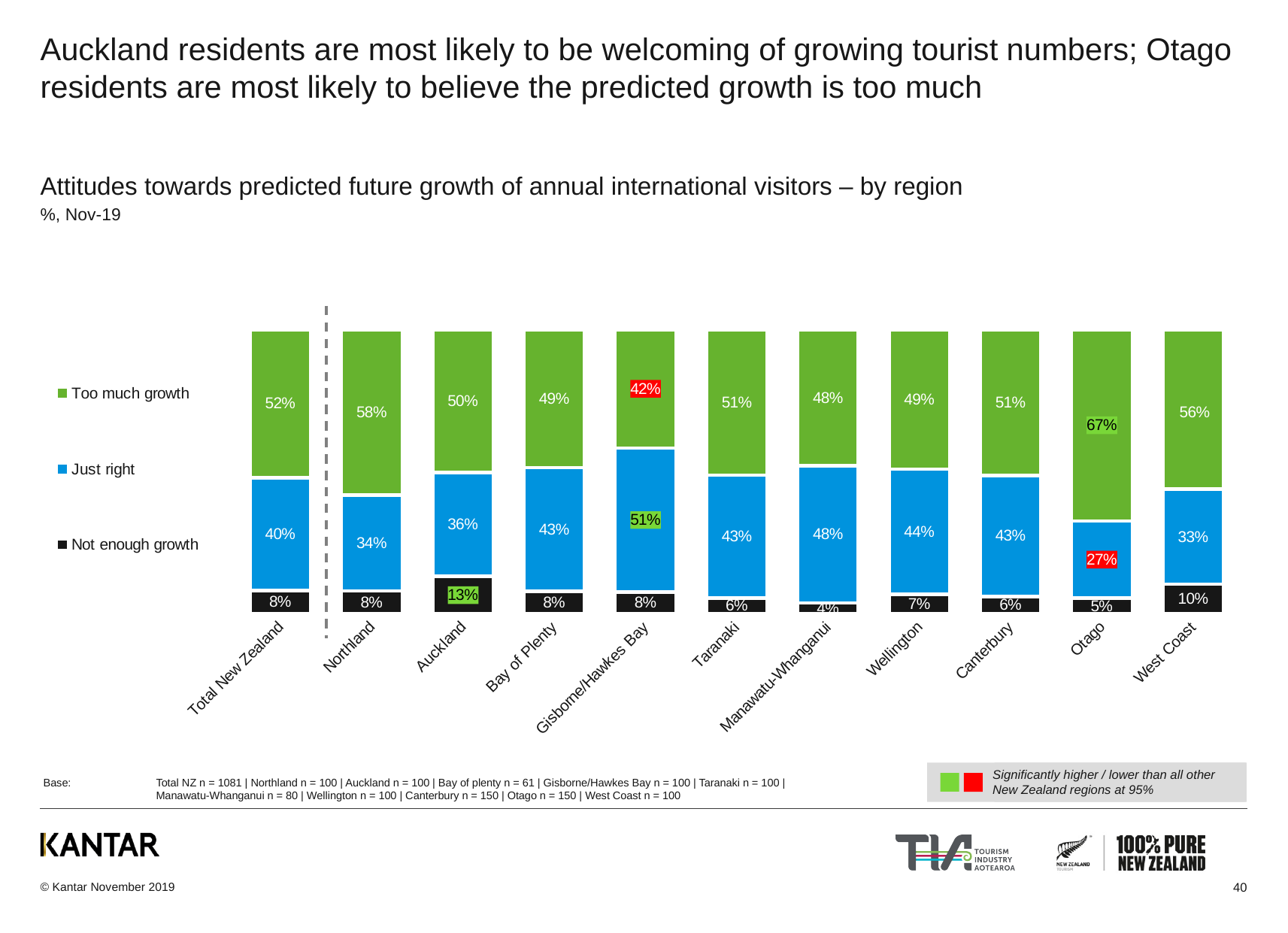
Which is larger, the 'Just right' value for Northland or for West Coast? Northland Which region has the lowest 'Just right' percentage? Otago What is the difference between the 'Too much growth' values for Otago and Total New Zealand? 15% What is the 'Just right' value for Gisborne/Hawkes Bay? 51% Which region has the highest 'Too much growth' percentage? Otago What is the 'Not enough growth' value for Auckland? 13% Which legend entry is shown in green? Too much growth What percentage of Otago residents think there is too much growth? 67% How many series does the legend list? 3 How many regions (categories) are shown on the x axis, including Total New Zealand? 11 What kind of chart is shown on the slide? Stacked bar chart What is the 'Too much growth' value for Northland? 58%